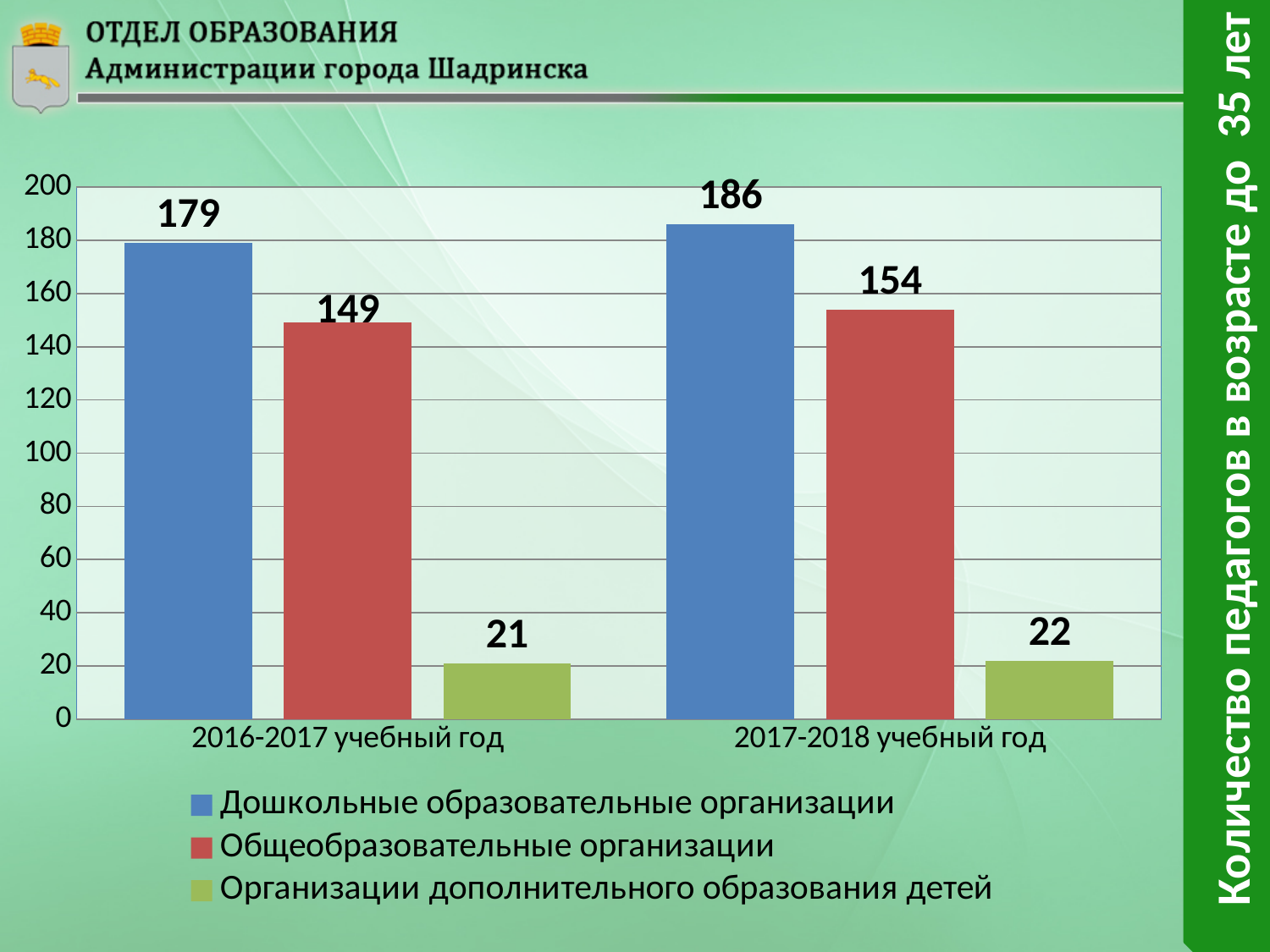
How many categories are shown on the x axis? 2 What kind of chart is shown on the slide? bar chart Which series has the highest value in 2017-2018 учебный год? Дошкольные образовательные организации What is the value for Общеобразовательные организации in 2017-2018 учебный год? 154 Which series has the lowest value in 2016-2017 учебный год? Организации дополнительного образования детей What is the difference between the values for Дошкольные образовательные организации in 2017-2018 учебный год and 2016-2017 учебный год? 7 What is the value for Организации дополнительного образования детей in 2016-2017 учебный год? 21 What is the value for Дошкольные образовательные организации in 2016-2017 учебный год? 179 Which is larger: Общеобразовательные организации in 2016-2017 учебный год or in 2017-2018 учебный год? 2017-2018 учебный год Is the value for Общеобразовательные организации in 2016-2017 учебный год greater or less than 140? greater How many series does the legend list? 3 Does the value for Организации дополнительного образования детей rise or fall from 2016-2017 учебный год to 2017-2018 учебный год? rise